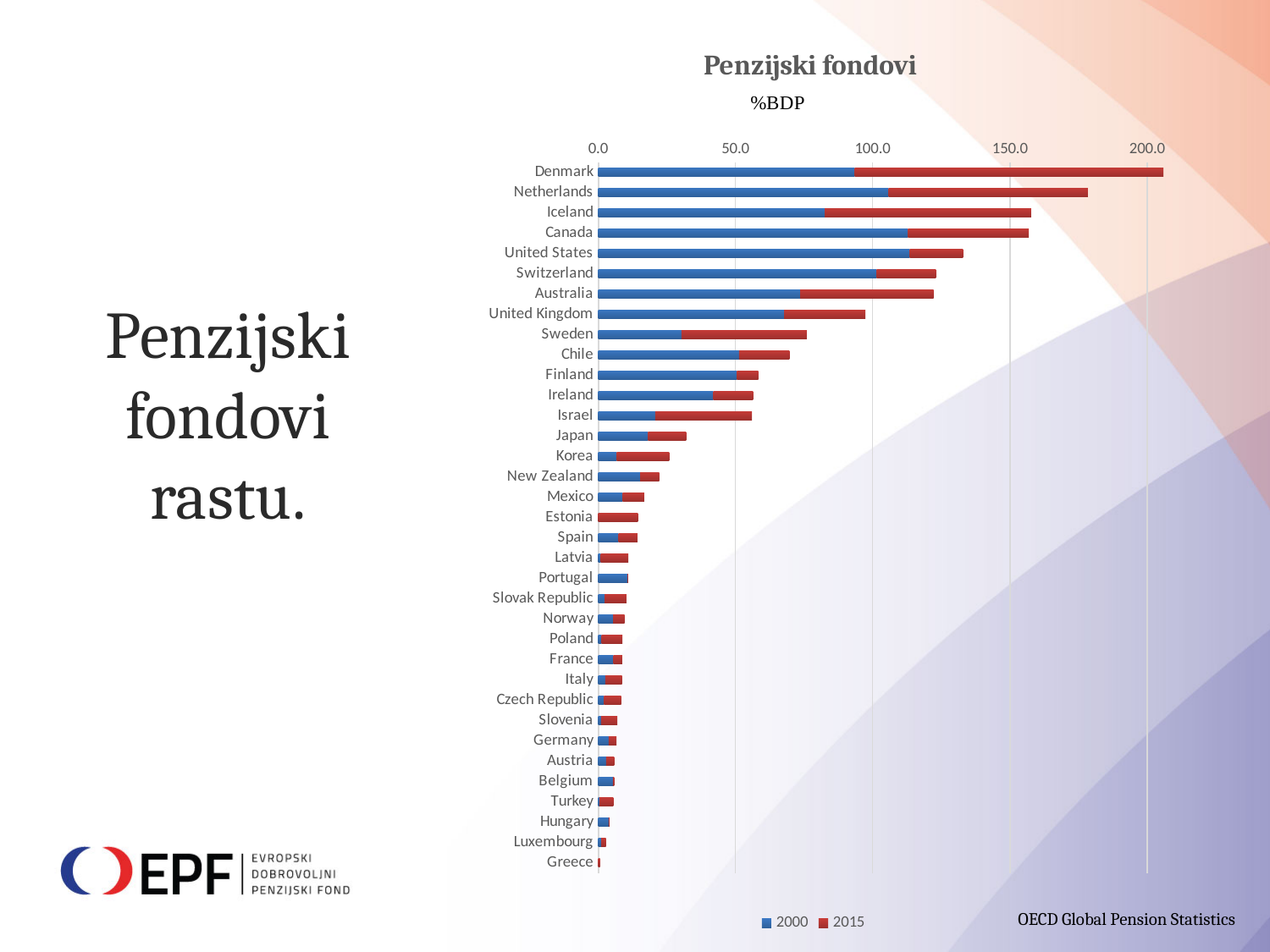
Is the total bar for Denmark greater or less than 200.0? greater Is the 2000 value for Denmark greater or less than 100.0? less How many series does the legend list? 2 How many countries are shown on the chart? 35 Is the total bar for Japan greater or less than 50.0? less Which country has the longest total bar? Denmark Which has the longer total bar, Chile or Japan? Chile What kind of chart is shown on the slide? bar chart Which years are listed in the chart legend? 2000 and 2015 What is the title of the chart? Penzijski fondovi Which country has the shortest total bar? Greece